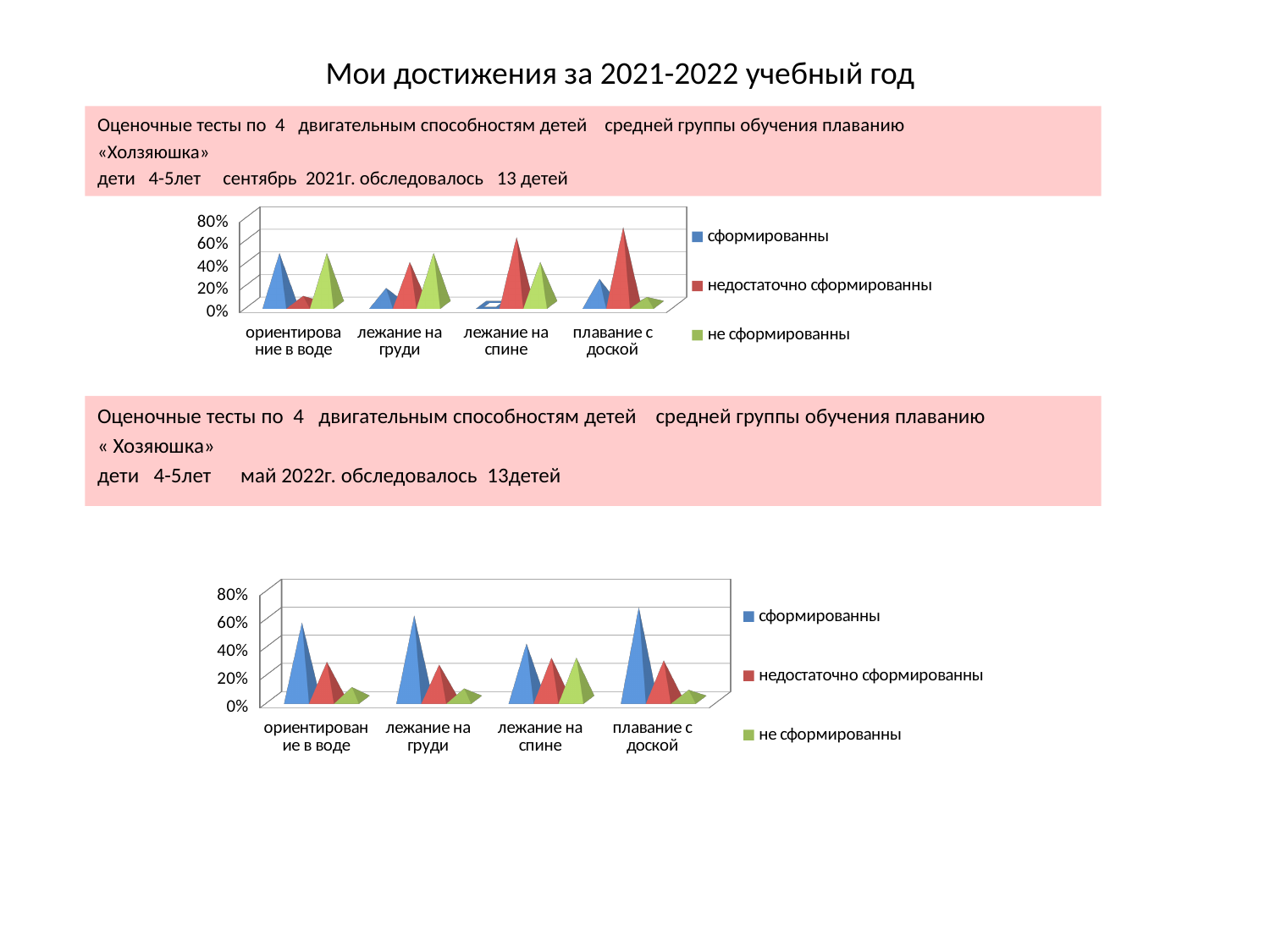
In the bottom chart (May 2022), which category has the highest value for 'сформированны'? плавание с доской In the top chart (September 2021), is the value for 'недостаточно сформированны' in 'плавание с доской' greater or less than 60%? greater In the top chart (September 2021), is the value for 'сформированны' in 'лежание на груди' greater or less than 20%? less How many series does the legend of the top chart (September 2021) list? 3 In the top chart (September 2021), for 'плавание с доской', which is larger: 'сформированны' or 'недостаточно сформированны'? недостаточно сформированны In the bottom chart (May 2022), for 'ориентирование в воде', which is larger: 'сформированны' or 'не сформированны'? сформированны In the top chart (September 2021), which category has the lowest value for 'сформированны'? лежание на спине In the bottom chart (May 2022), is the value for 'не сформированны' in 'лежание на груди' greater or less than 20%? less What kind of chart is the top chart (September 2021)? bar chart In the top chart (September 2021), which category has the highest value for 'недостаточно сформированны'? плавание с доской How many categories are shown on the x axis of the bottom chart (May 2022)? 4